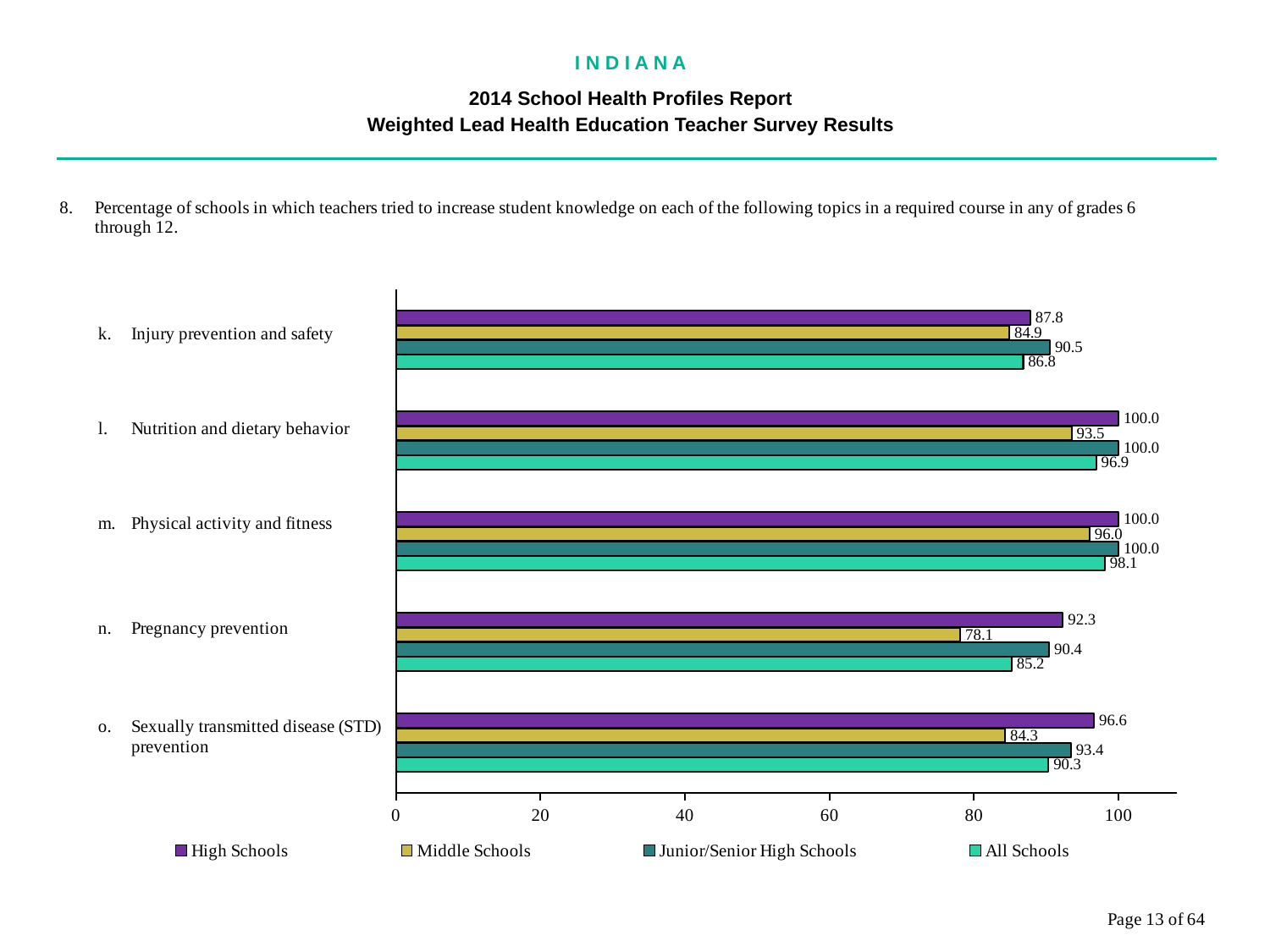
Which is larger for Injury prevention and safety: the High Schools value or the Junior/Senior High Schools value? Junior/Senior High Schools Which topic has the highest All Schools value? Physical activity and fitness Which series is shown in purple in the legend? High Schools What is the value for Middle Schools for Pregnancy prevention? 78.1 How many topics are shown on the chart? 5 Which topic has the lowest Middle Schools value? Pregnancy prevention What is the value for High Schools for Sexually transmitted disease (STD) prevention? 96.6 What is the value for All Schools for Injury prevention and safety? 86.8 What is the difference between the High Schools and Middle Schools values for Pregnancy prevention? 14.2 How many series does the legend list? 4 What is the value for Junior/Senior High Schools for Nutrition and dietary behavior? 100.0 What kind of chart is shown on the slide? Bar chart